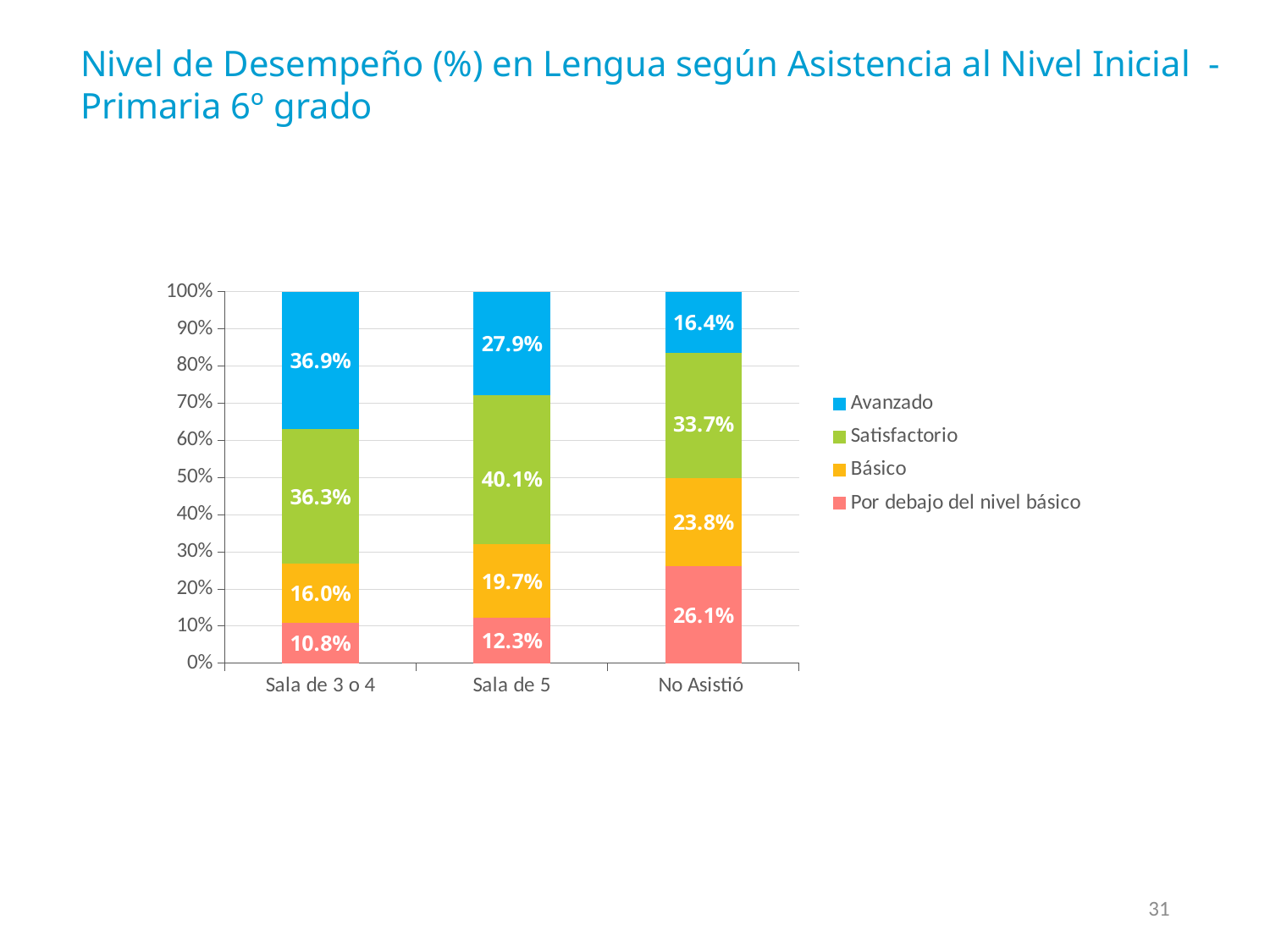
What kind of chart is shown on the slide? Stacked bar chart What is the difference between the Avanzado values for Sala de 3 o 4 and No Asistió? 20.5 percentage points What is the Básico value for No Asistió? 23.8% Do the Avanzado values rise or fall from Sala de 3 o 4 to No Asistió? Fall What is the Avanzado value for Sala de 3 o 4? 36.9% Which category has the lowest Por debajo del nivel básico value? Sala de 3 o 4 Which is larger: the Básico value for Sala de 5 or the Básico value for No Asistió? No Asistió What is the Por debajo del nivel básico value for No Asistió? 26.1% What is the Satisfactorio value for Sala de 5? 40.1% How many categories are shown on the x axis? 3 Which category has the highest Avanzado value? Sala de 3 o 4 How many series does the legend list? 4